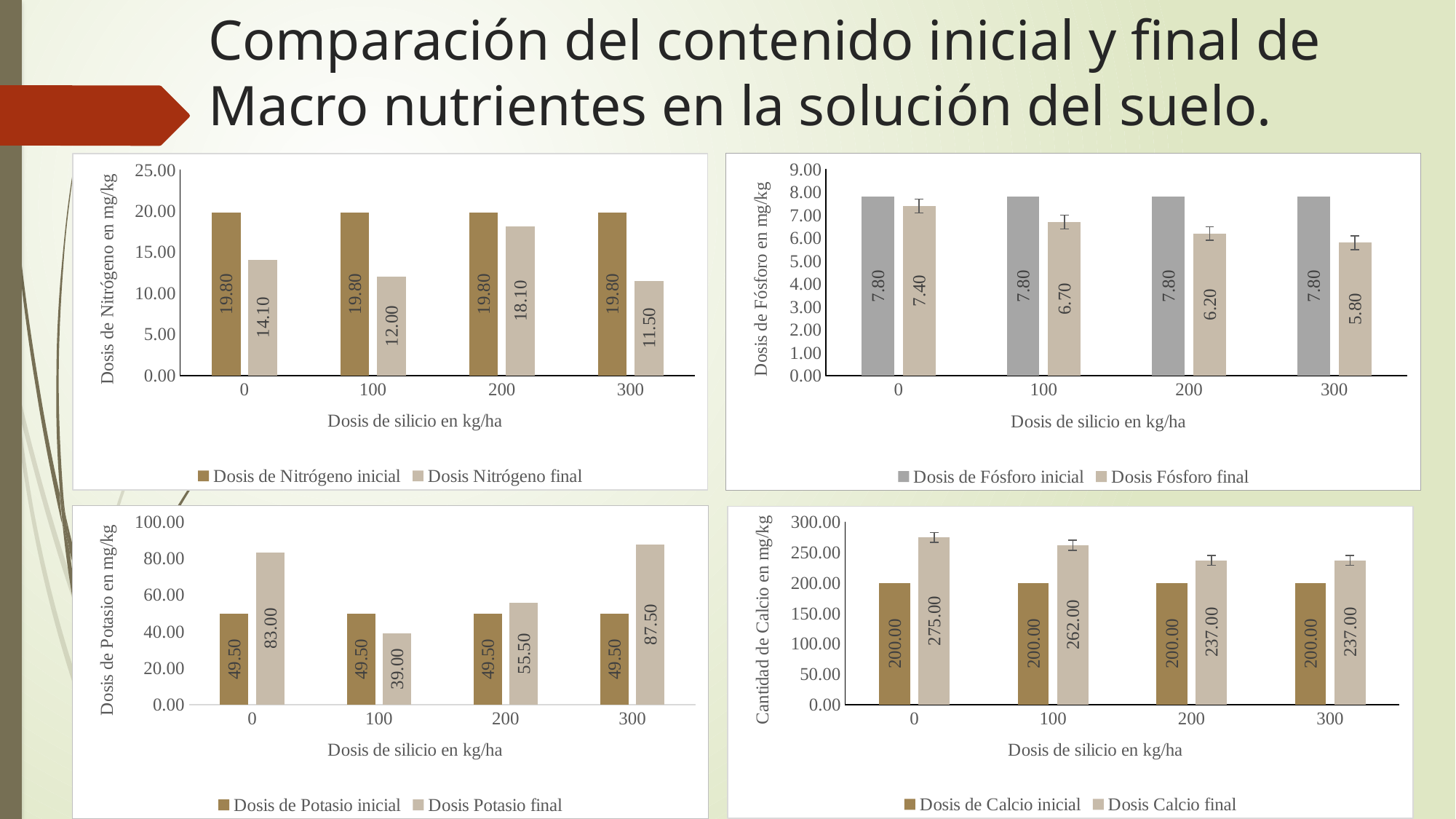
In the bottom-right chart (Calcio), what is the difference between Dosis Calcio final and Dosis de Calcio inicial at a silicon dose of 100 kg/ha? 62.00 In the top-left chart (Nitrógeno), at which silicon dose is Dosis Nitrógeno final lowest? 300 In the bottom-right chart (Calcio), what is the value of Dosis Calcio final at a silicon dose of 0 kg/ha? 275.00 In the bottom-left chart (Potasio), at which silicon dose is Dosis Potasio final highest? 300 In the bottom-left chart (Potasio), which is larger at a silicon dose of 100 kg/ha: Dosis de Potasio inicial or Dosis Potasio final? Dosis de Potasio inicial In the top-left chart (Nitrógeno), what is the value of Dosis Nitrógeno final at a silicon dose of 200 kg/ha? 18.10 In the top-right chart (Fósforo), does Dosis Fósforo final rise or fall as the silicon dose increases from 0 to 300 kg/ha? fall How many silicon dose categories are shown on the x axis of the bottom-right chart (Calcio)? 4 In the top-right chart (Fósforo), what is the value of Dosis Fósforo final at a silicon dose of 100 kg/ha? 6.70 In the top-left chart (Nitrógeno), what is the difference between Dosis de Nitrógeno inicial and Dosis Nitrógeno final at a silicon dose of 0 kg/ha? 5.70 In the top-right chart (Fósforo), how many series does the legend list? 2 In the bottom-left chart (Potasio), what is the value of Dosis Potasio final at a silicon dose of 100 kg/ha? 39.00